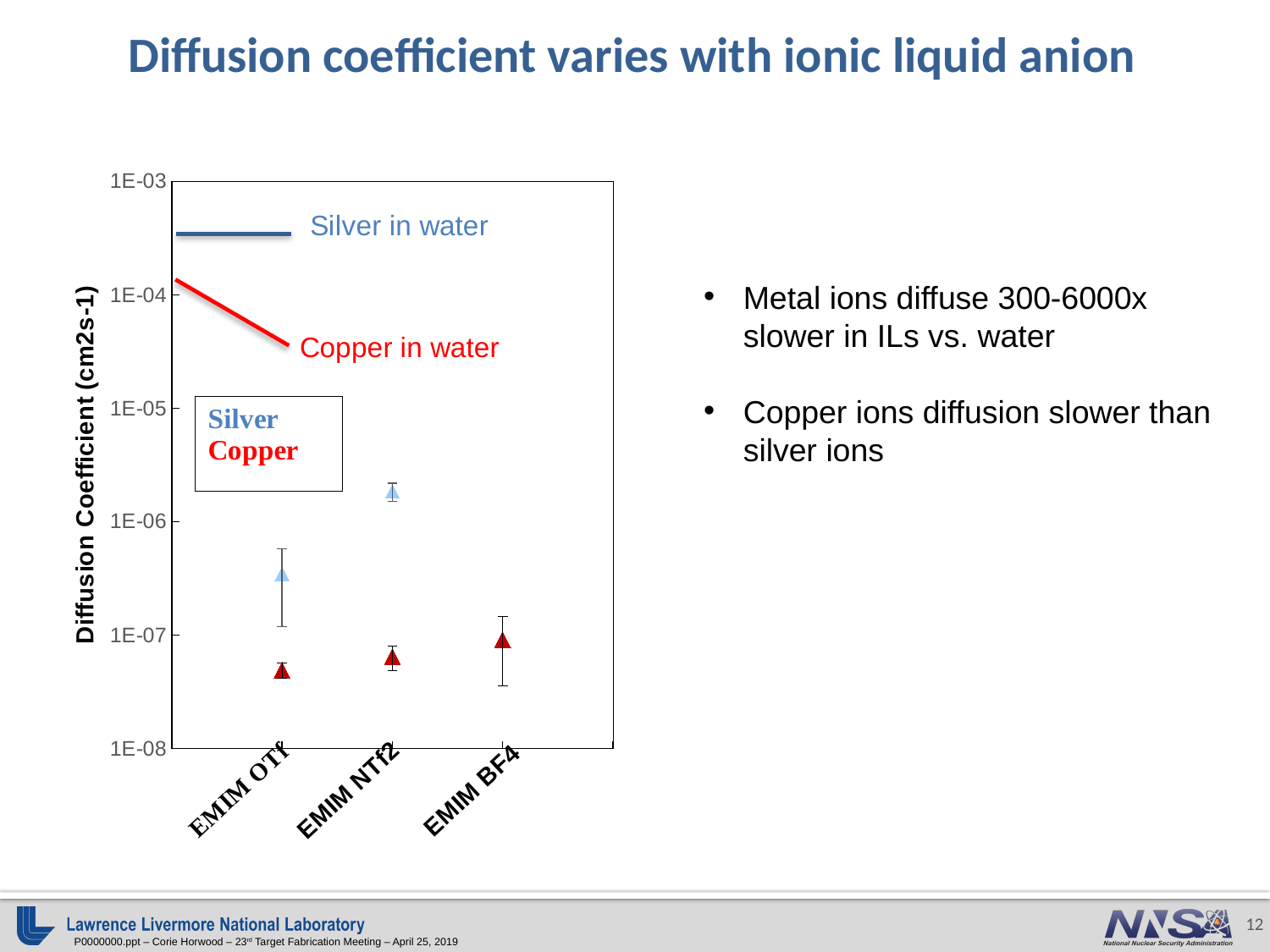
Is the Silver value for EMIM NTf2 greater or less than 1E-06? greater Does the Silver diffusion coefficient rise or fall from EMIM OTf to EMIM NTf2? rise Is the Silver value for EMIM OTf greater or less than 1E-07? greater How many ionic liquid categories are shown on the x axis? 3 Is the Copper value for EMIM NTf2 greater or less than 1E-07? less Which two reference lines for diffusion in water are drawn on the chart? Silver in water and Copper in water At EMIM NTf2, which series has the larger diffusion coefficient, Silver or Copper? Silver How many series does the legend list? 2 What is the label of the y axis? Diffusion Coefficient (cm2s-1) What kind of chart is shown on the slide? scatter chart For the Silver series, which ionic liquid has the highest diffusion coefficient? EMIM NTf2